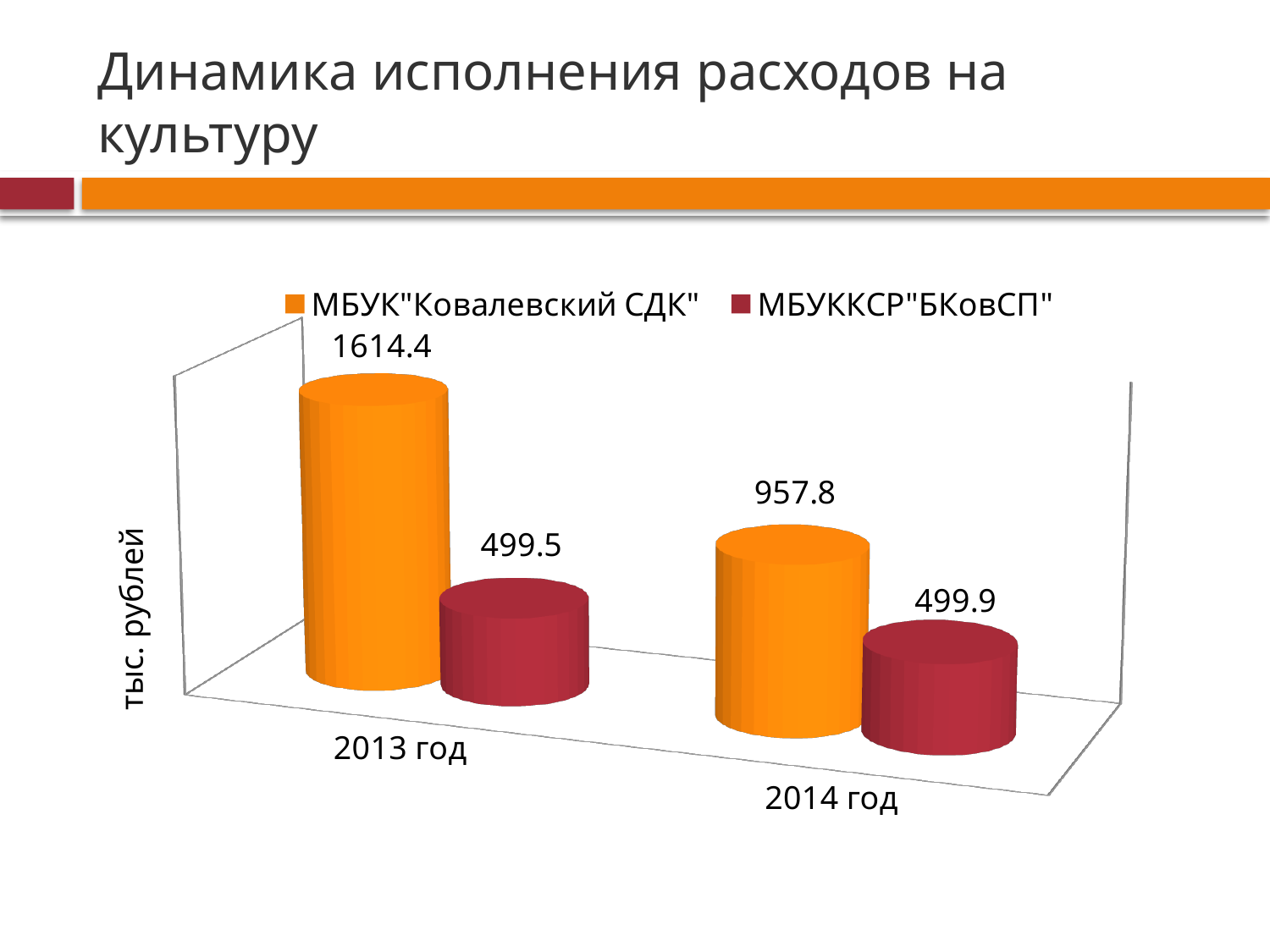
What is the difference between the МБУК"Ковалевский СДК" values for 2013 год and 2014 год? 656.6 What is the difference between the two series' values in 2014 год? 457.9 What is the value for МБУККСР"БКовСП" in 2014 год? 499.9 What is the value for МБУККСР"БКовСП" in 2013 год? 499.5 How many series does the legend list? 2 Which series has the lowest value in 2013 год? МБУККСР"БКовСП" In which year is the value for МБУК"Ковалевский СДК" highest? 2013 год Which is larger in 2014 год: МБУК"Ковалевский СДК" or МБУККСР"БКовСП"? МБУК"Ковалевский СДК" What is the value for МБУК"Ковалевский СДК" in 2013 год? 1614.4 How many years are shown on the x axis? 2 What kind of chart is shown on the slide? Bar chart What is the value for МБУК"Ковалевский СДК" in 2014 год? 957.8